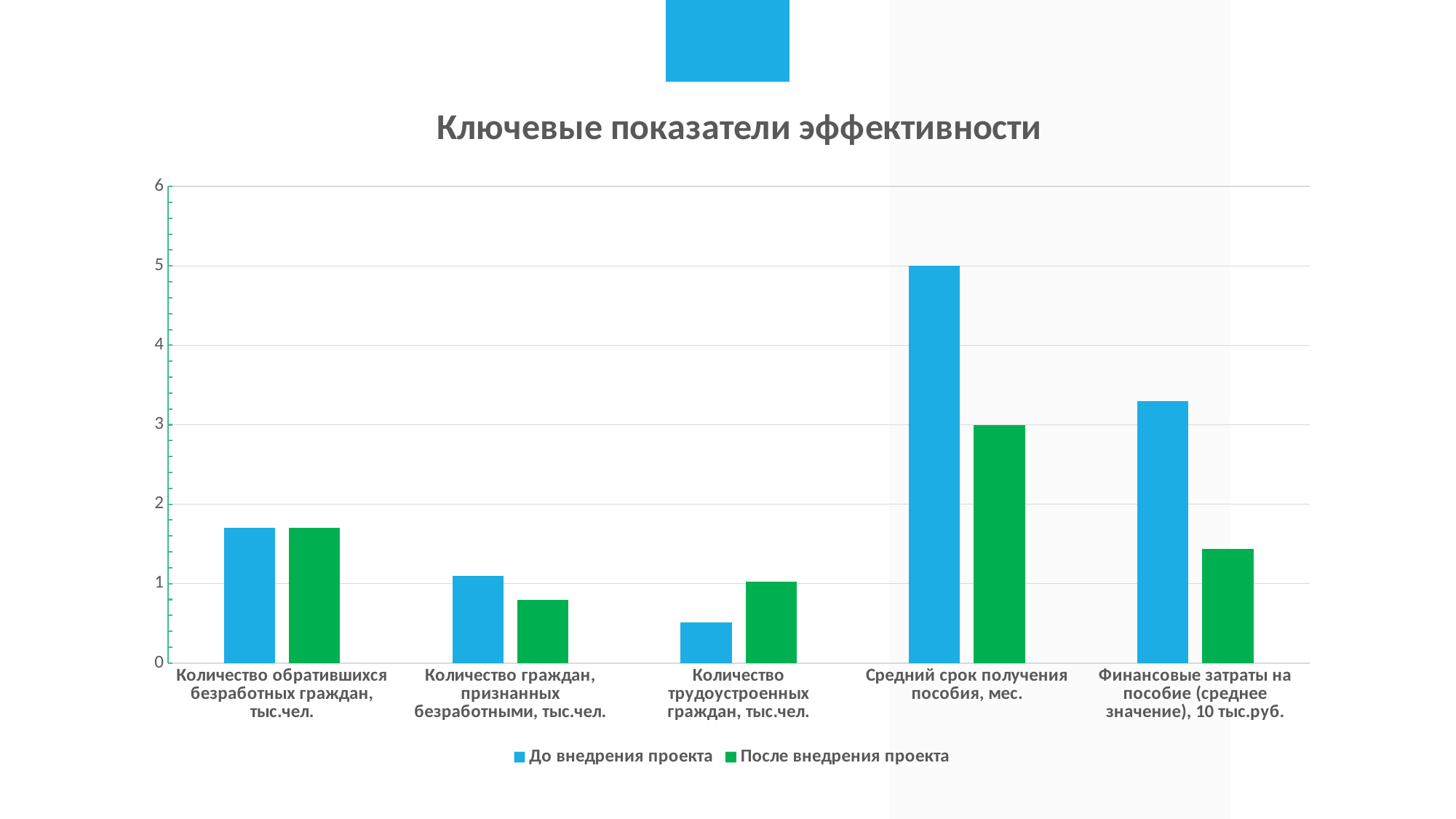
Which category has the highest value in the 'До внедрения проекта' series? Средний срок получения пособия, мес. Which category has the lowest value in the 'До внедрения проекта' series? Количество трудоустроенных граждан, тыс.чел. Is the 'До внедрения проекта' value for 'Количество трудоустроенных граждан, тыс.чел.' greater or less than 1? less What is the value for 'Средний срок получения пособия, мес.' in the 'До внедрения проекта' series? 5 What is the value for 'Средний срок получения пособия, мес.' in the 'После внедрения проекта' series? 3 How many categories are shown on the x axis? 5 What is the difference between the 'До внедрения проекта' and 'После внедрения проекта' values for 'Средний срок получения пособия, мес.'? 2 How many series does the legend list? 2 For 'Финансовые затраты на пособие (среднее значение), 10 тыс.руб.', which series has the larger value: 'До внедрения проекта' or 'После внедрения проекта'? До внедрения проекта Is the 'До внедрения проекта' value for 'Финансовые затраты на пособие (среднее значение), 10 тыс.руб.' greater or less than 3? greater What kind of chart is shown on the slide? bar chart What is the title of the chart? Ключевые показатели эффективности